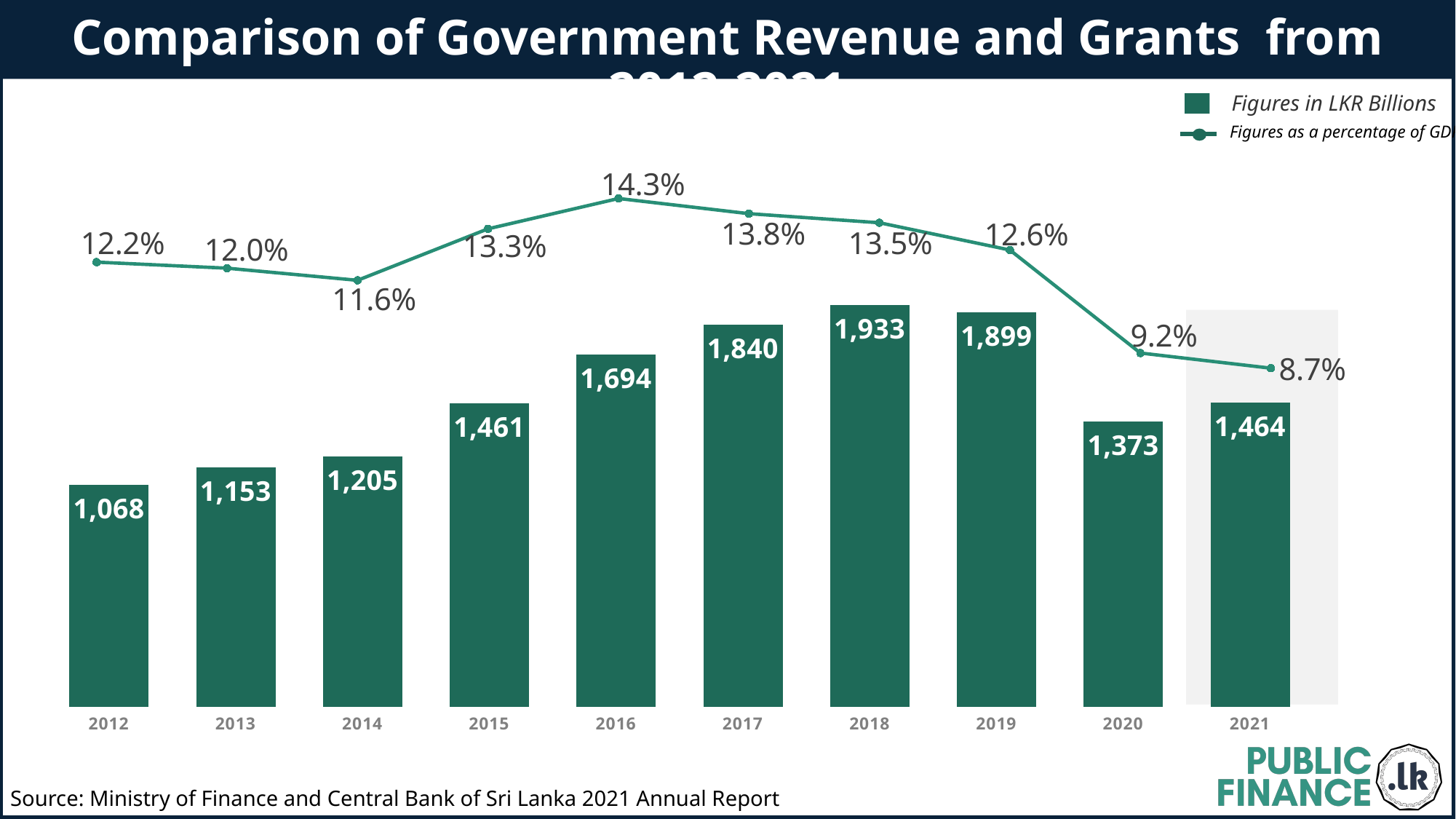
How many series does the legend list? 2 What is the difference in LKR billions between the 2019 and 2020 figures? 526 What is the government revenue and grants figure in LKR billions for 2012? 1,068 What percentage of GDP did government revenue and grants represent in 2016? 14.3% What kind of chart is shown on the slide? Combined bar and line chart How many years are shown on the x axis of the chart? 10 Which year has the lowest percentage of GDP value on the line? 2021 Which year has the highest government revenue and grants in LKR billions? 2018 What percentage of GDP did government revenue and grants represent in 2021? 8.7% Does the percentage of GDP line rise or fall from 2019 to 2021? Fall What is the government revenue and grants figure in LKR billions for 2018? 1,933 Which year has the larger revenue and grants figure in LKR billions, 2015 or 2021? 2021